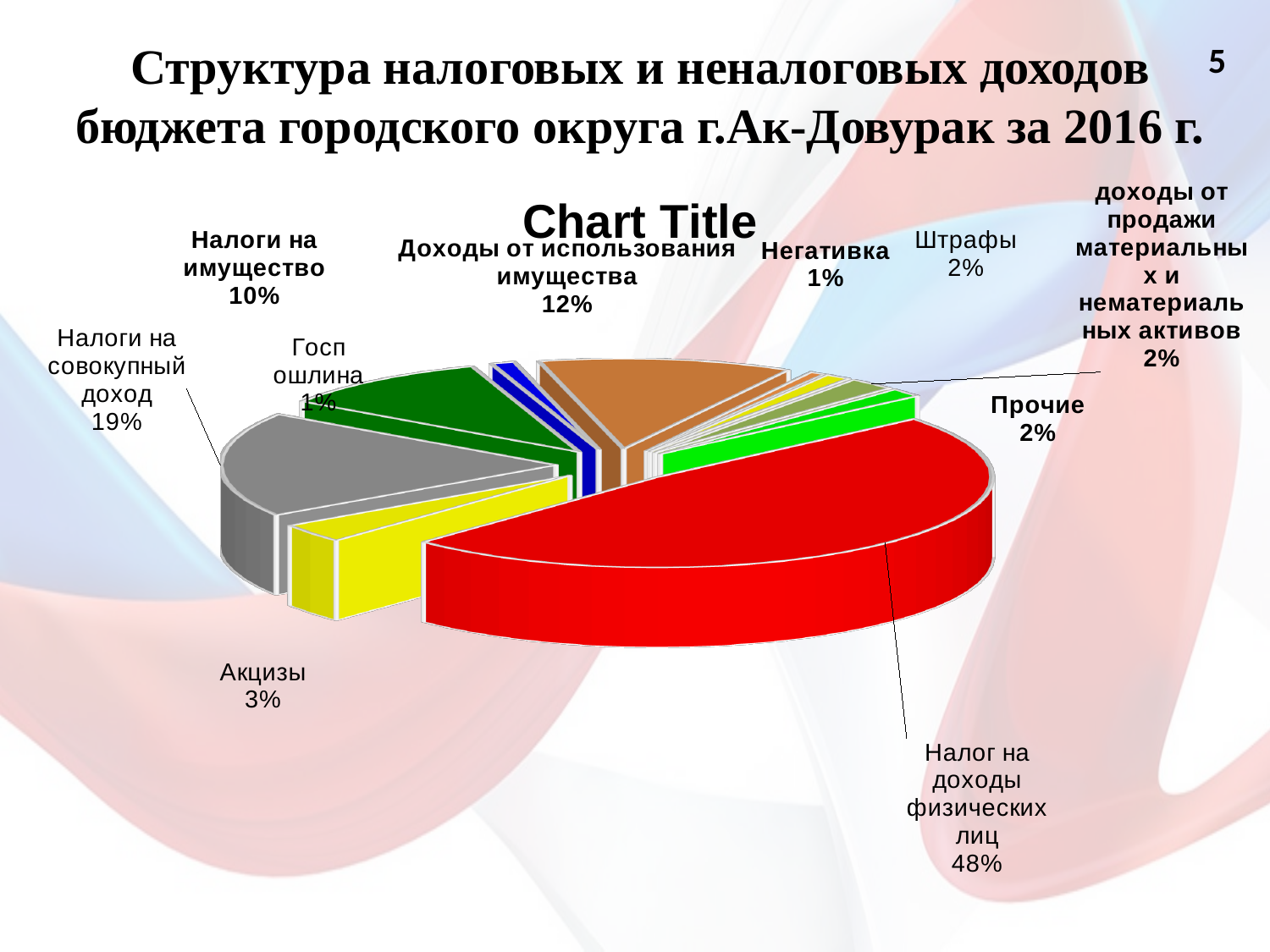
What share of the pie does Налог на доходы физических лиц hold? 48% What is the difference between the shares of Налоги на имущество and Акцизы? 7% What is the value shown for Госпошлина? 1% Which is larger, the share for Налоги на имущество or the share for Доходы от использования имущества? Доходы от использования имущества What is the value shown for Налоги на совокупный доход? 19% What colour is the slice for Налог на доходы физических лиц? Red Which category has the largest slice of the pie? Налог на доходы физических лиц What is the value shown for Акцизы? 3% What is the difference between the shares of Налог на доходы физических лиц and Налоги на совокупный доход? 29% What is the value shown for Доходы от использования имущества? 12% What kind of chart is shown on the slide? Pie chart How many categories are shown in the pie chart? 10